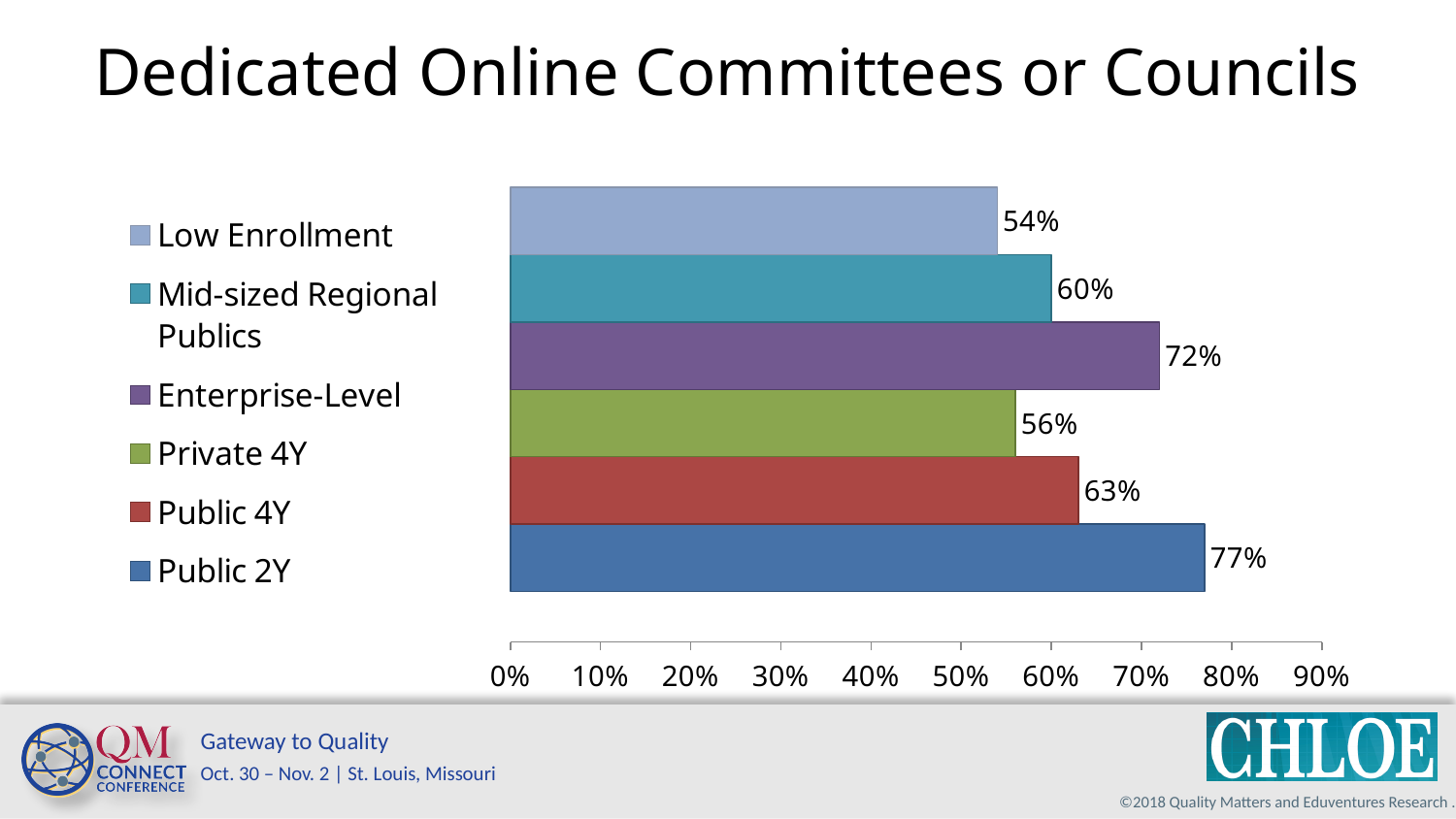
Is the value for Public 4Y greater or less than 60%? greater Which category has the lowest value? Low Enrollment What is the value for Public 2Y? 77% What is the value for Enterprise-Level? 72% What is the value for Low Enrollment? 54% What is the difference between the values for Public 2Y and Public 4Y? 14% What is the title of the chart? Dedicated Online Committees or Councils What is the value for Mid-sized Regional Publics? 60% Which category has the highest value? Public 2Y What kind of chart is shown on the slide? bar chart Which is larger, the value for Private 4Y or the value for Mid-sized Regional Publics? Mid-sized Regional Publics How many categories does the legend list? 6